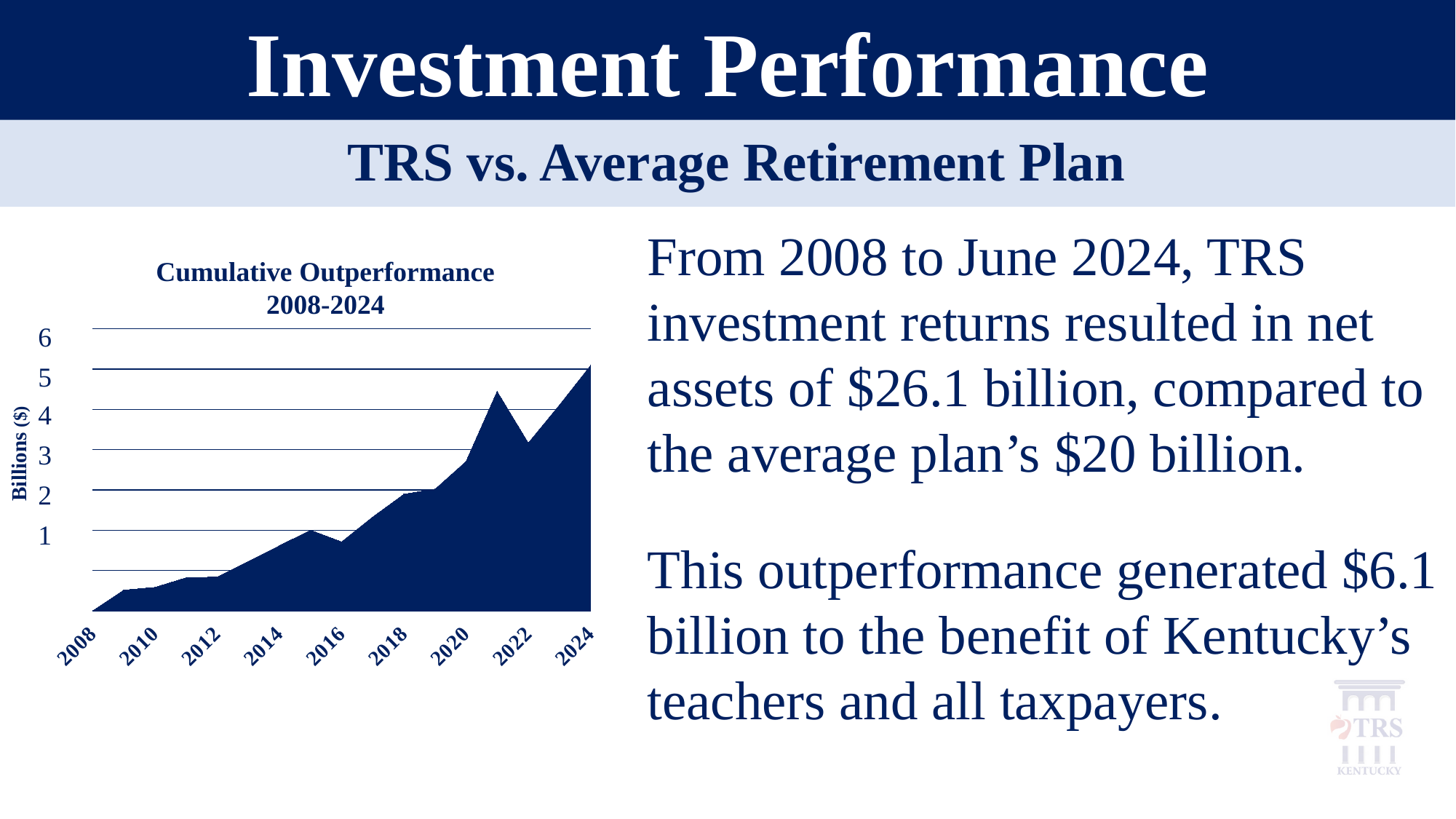
Is the value for 2012 greater or less than 1? less Does the cumulative outperformance generally rise or fall from 2008 to 2024? Rise What is the title of the chart? Cumulative Outperformance 2008-2024 What kind of chart is shown on the slide? Area chart Is the value for 2022 greater or less than 3? greater Is the value for 2024 greater or less than 5? greater Which year has the lowest cumulative outperformance in the chart? 2008 Which year has the highest cumulative outperformance in the chart? 2024 Which is larger, the value for 2020 or the value for 2014? 2020 What is the label on the vertical axis of the chart? Billions ($)